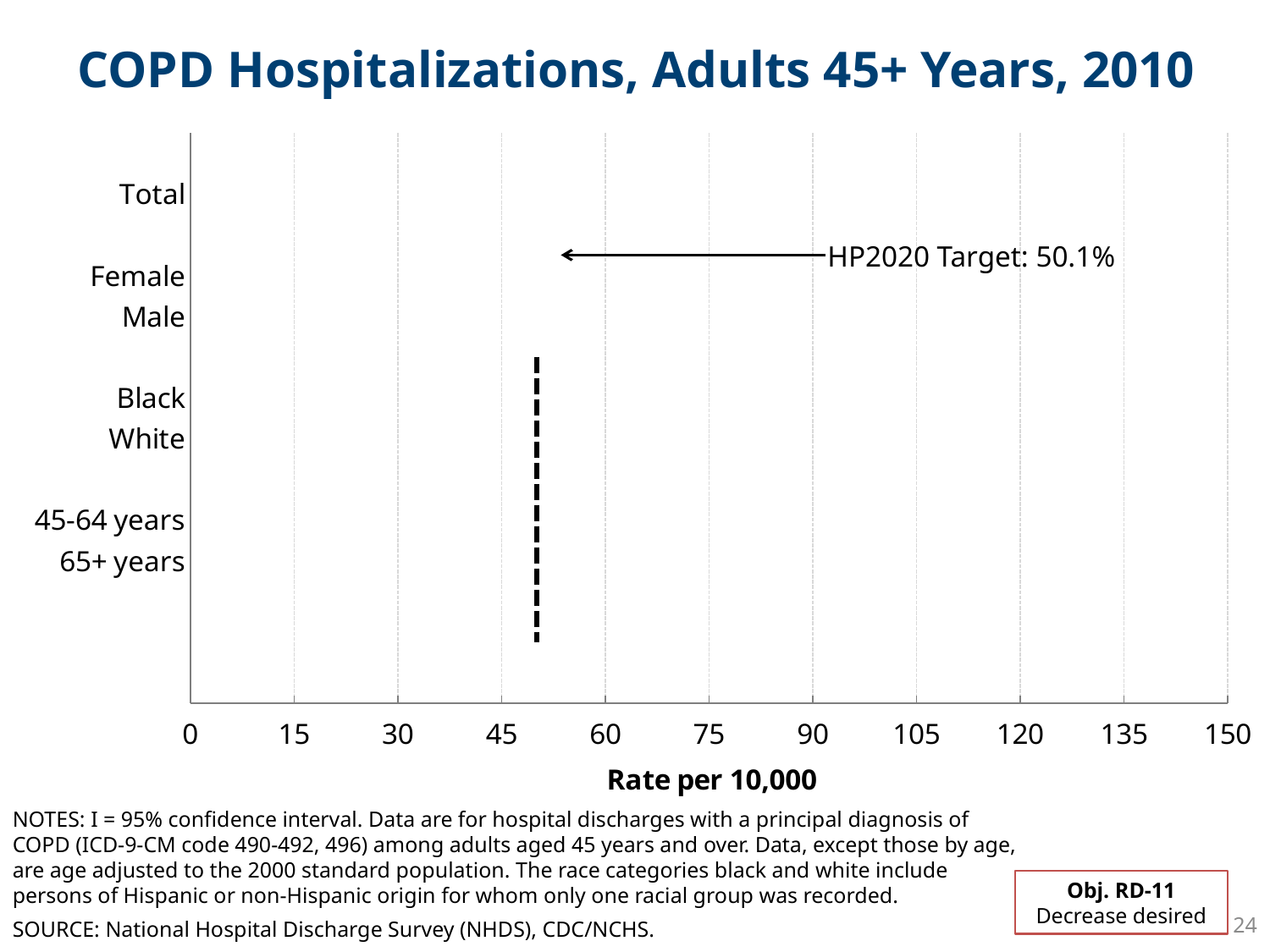
What is the label of the horizontal axis? Rate per 10,000 Is the HP2020 Target line greater or less than 60 on the horizontal axis? less Is the HP2020 Target line greater or less than 45 on the horizontal axis? greater What is the HP2020 Target value shown on the chart? 50.1% What is the title of the chart? COPD Hospitalizations, Adults 45+ Years, 2010 How many categories are listed on the vertical axis of the chart? 7